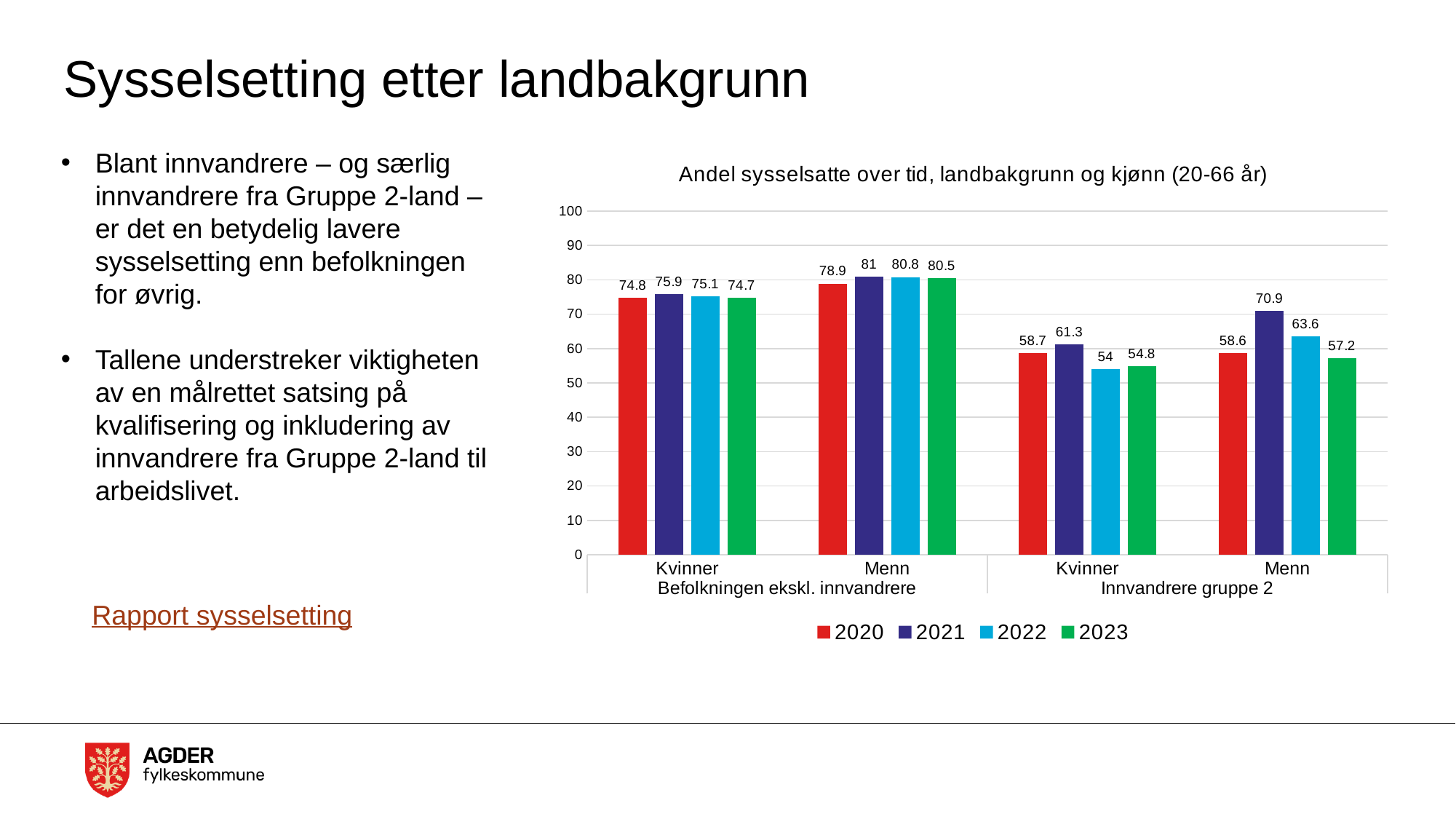
What is the difference between the 2021 and 2023 values for Menn in Innvandrere gruppe 2? 13.7 What is the 2020 value for Kvinner in Befolkningen ekskl. innvandrere? 74.8 Which year has the highest value for Menn in Innvandrere gruppe 2? 2021 Which is larger: the 2022 value for Menn in Befolkningen ekskl. innvandrere or the 2022 value for Menn in Innvandrere gruppe 2? Menn in Befolkningen ekskl. innvandrere What is the title of the chart? Andel sysselsatte over tid, landbakgrunn og kjønn (20-66 år) How many series does the legend list? 4 What kind of chart is shown on the slide? Bar chart What is the 2022 value for Kvinner in Innvandrere gruppe 2? 54 What is the 2023 value for Menn in Innvandrere gruppe 2? 57.2 Is the 2021 value for Kvinner in Innvandrere gruppe 2 greater or less than 70? less What is the 2021 value for Menn in Befolkningen ekskl. innvandrere? 81 Which year has the lowest value for Kvinner in Innvandrere gruppe 2? 2022